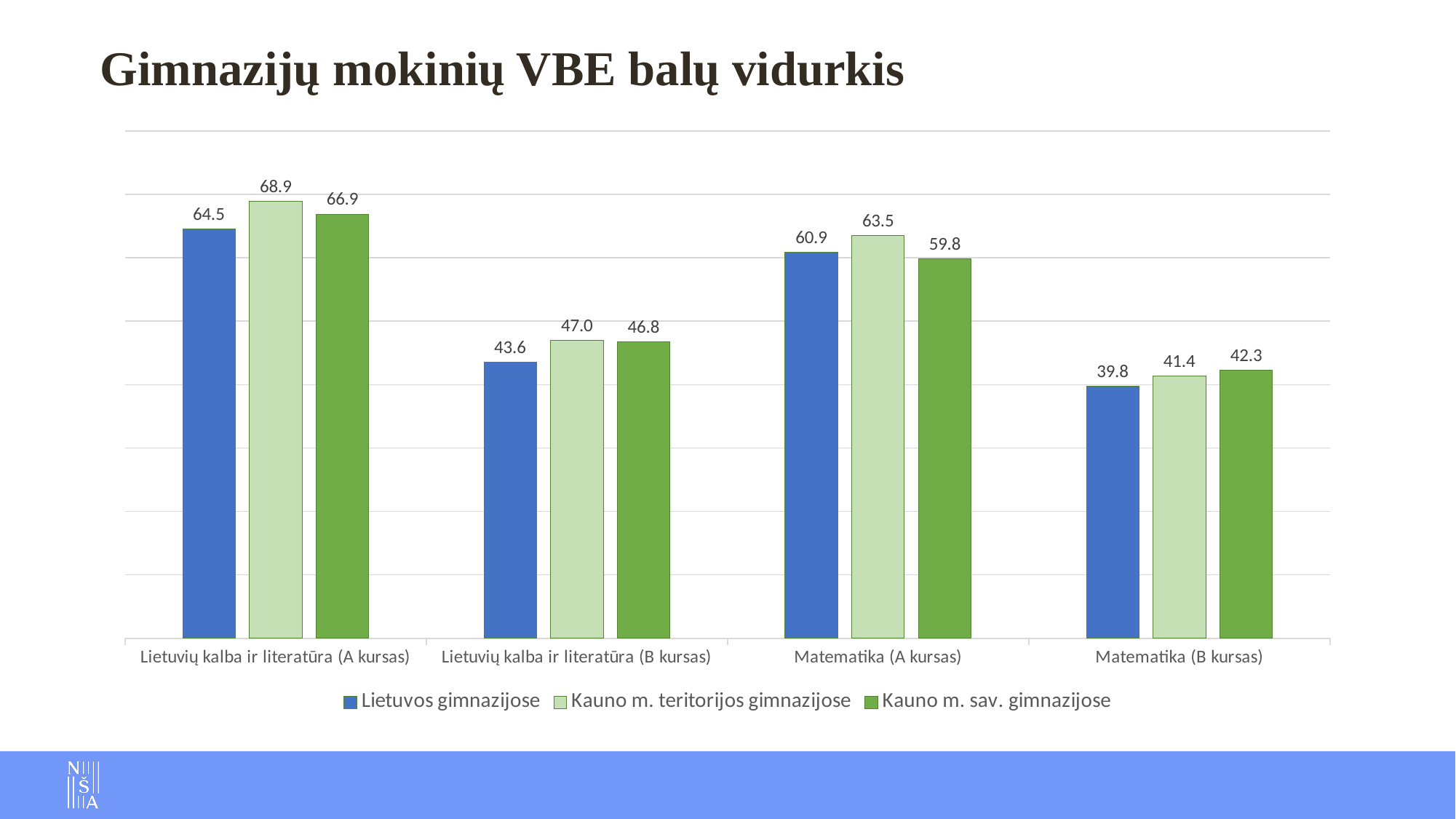
Which series has the highest value in Lietuvių kalba ir literatūra (B kursas)? Kauno m. teritorijos gimnazijose What is the difference between Kauno m. teritorijos gimnazijose and Lietuvos gimnazijose in Lietuvių kalba ir literatūra (A kursas)? 4.4 In Matematika (A kursas), which is larger: Lietuvos gimnazijose or Kauno m. sav. gimnazijose? Lietuvos gimnazijose What kind of chart is shown on the slide? bar chart What is the title of the slide? Gimnazijų mokinių VBE balų vidurkis What is the value for Lietuvos gimnazijose in Lietuvių kalba ir literatūra (A kursas)? 64.5 Which category has the lowest value for Lietuvos gimnazijose? Matematika (B kursas) What is the value for Kauno m. sav. gimnazijose in Matematika (B kursas)? 42.3 What is the value for Kauno m. teritorijos gimnazijose in Matematika (A kursas)? 63.5 How many categories are shown on the x axis? 4 How many series does the legend list? 3 Which series is shown in dark green? Kauno m. sav. gimnazijose